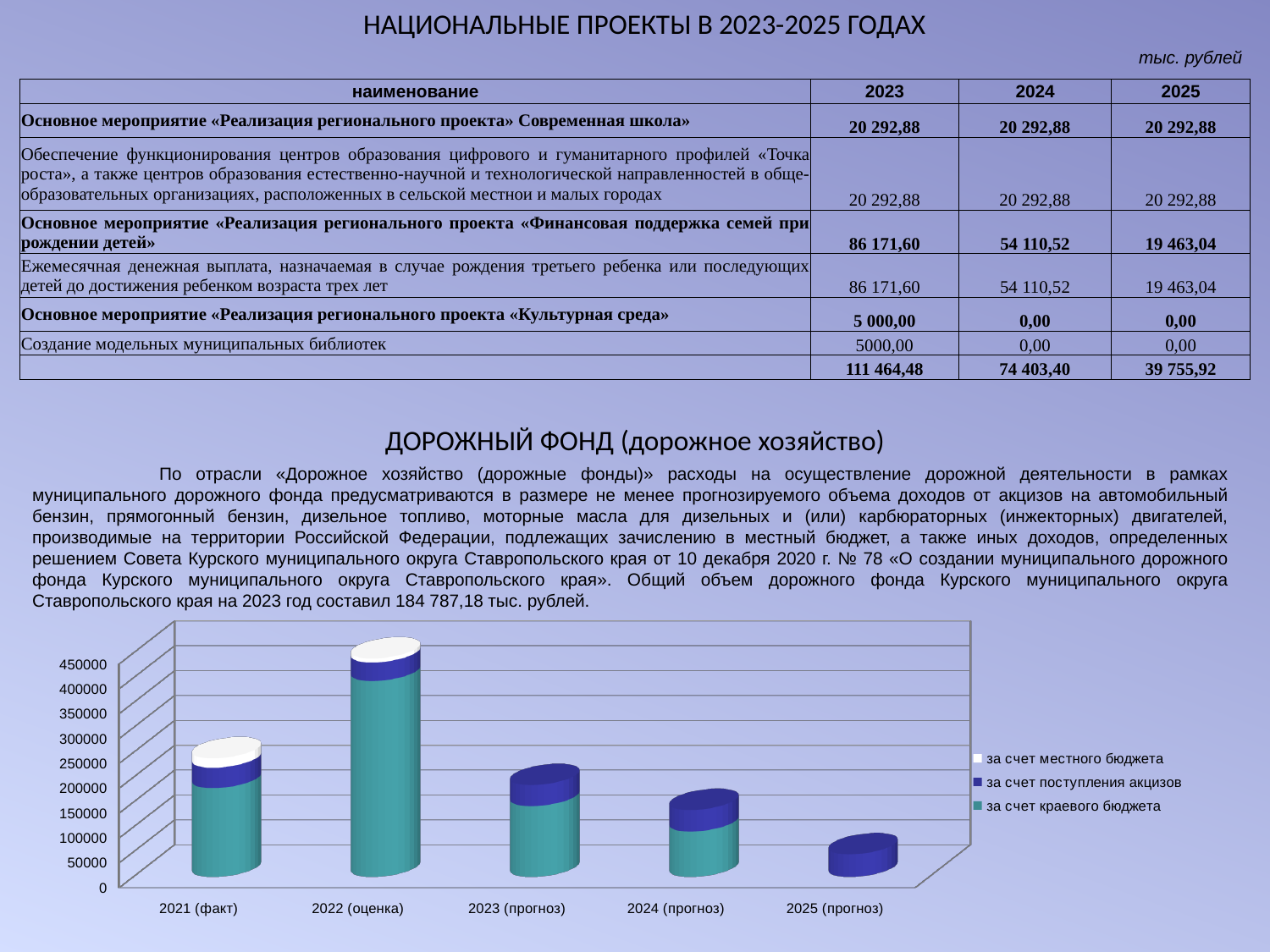
Is the total stacked value for 2022 (оценка) greater or less than 400000? greater Which category has the tallest stacked bar in the chart? 2022 (оценка) Which legend entry is shown in white in the bar chart? за счет местного бюджета Is the total stacked value for 2023 (прогноз) greater or less than 300000? less Which category has the shortest stacked bar in the chart? 2025 (прогноз) How many series does the legend of the bar chart list? 3 Do the stacked bar totals rise or fall from 2022 (оценка) to 2025 (прогноз)? fall Which stacked bar is taller, 2021 (факт) or 2023 (прогноз)? 2021 (факт) Is the total stacked value for 2021 (факт) greater or less than 200000? greater What kind of chart is shown at the bottom of the slide? bar chart How many categories are shown on the x axis of the bar chart? 5